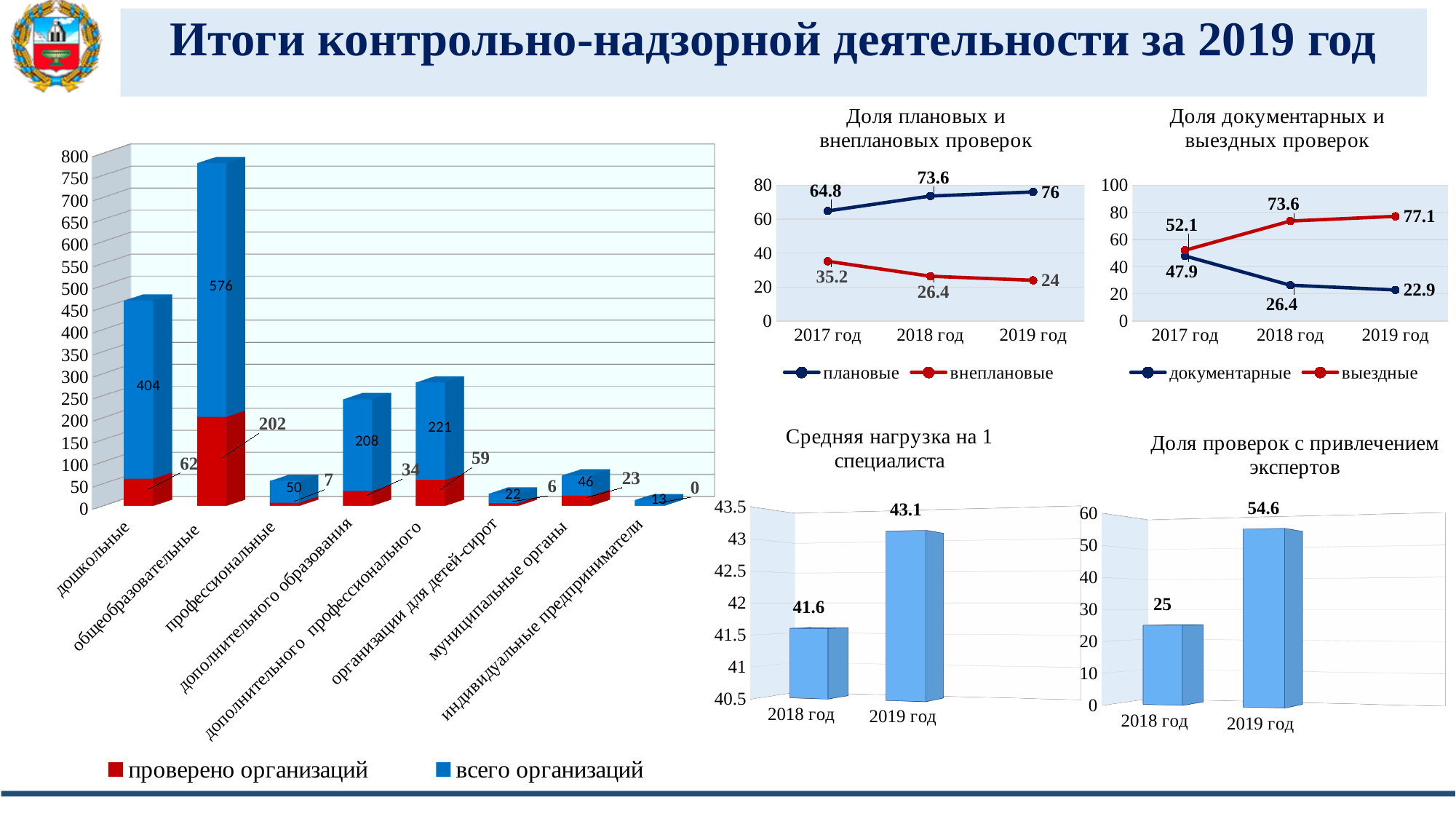
In the chart 'Доля документарных и выездных проверок', what is the value for 'выездные' in 2018 год? 73.6 In the chart 'Доля плановых и внеплановых проверок', what is the value for 'плановые' in 2019 год? 76 On the left stacked bar chart, which category has the highest value of 'всего организаций'? общеобразовательные What type of chart is 'Доля проверок с привлечением экспертов'? bar chart On the left stacked bar chart, what is the value of 'проверено организаций' for 'дошкольные'? 62 On the left stacked bar chart, what is the total of the stacked bar for 'общеобразовательные'? 778 In the chart 'Средняя нагрузка на 1 специалиста', what is the difference between 2019 год and 2018 год? 1.5 On the left stacked bar chart, how many categories are shown on the x axis? 8 On the left stacked bar chart, what is the value of 'всего организаций' for 'общеобразовательные'? 576 In the chart 'Доля плановых и внеплановых проверок', do the values for 'внеплановые' rise or fall from 2017 год to 2019 год? fall On the left stacked bar chart, what is the difference between 'всего организаций' for 'дополнительного профессионального' and for 'дополнительного образования'? 13 In the chart 'Доля документарных и выездных проверок', which is larger in 2017 год: 'документарные' or 'выездные'? выездные